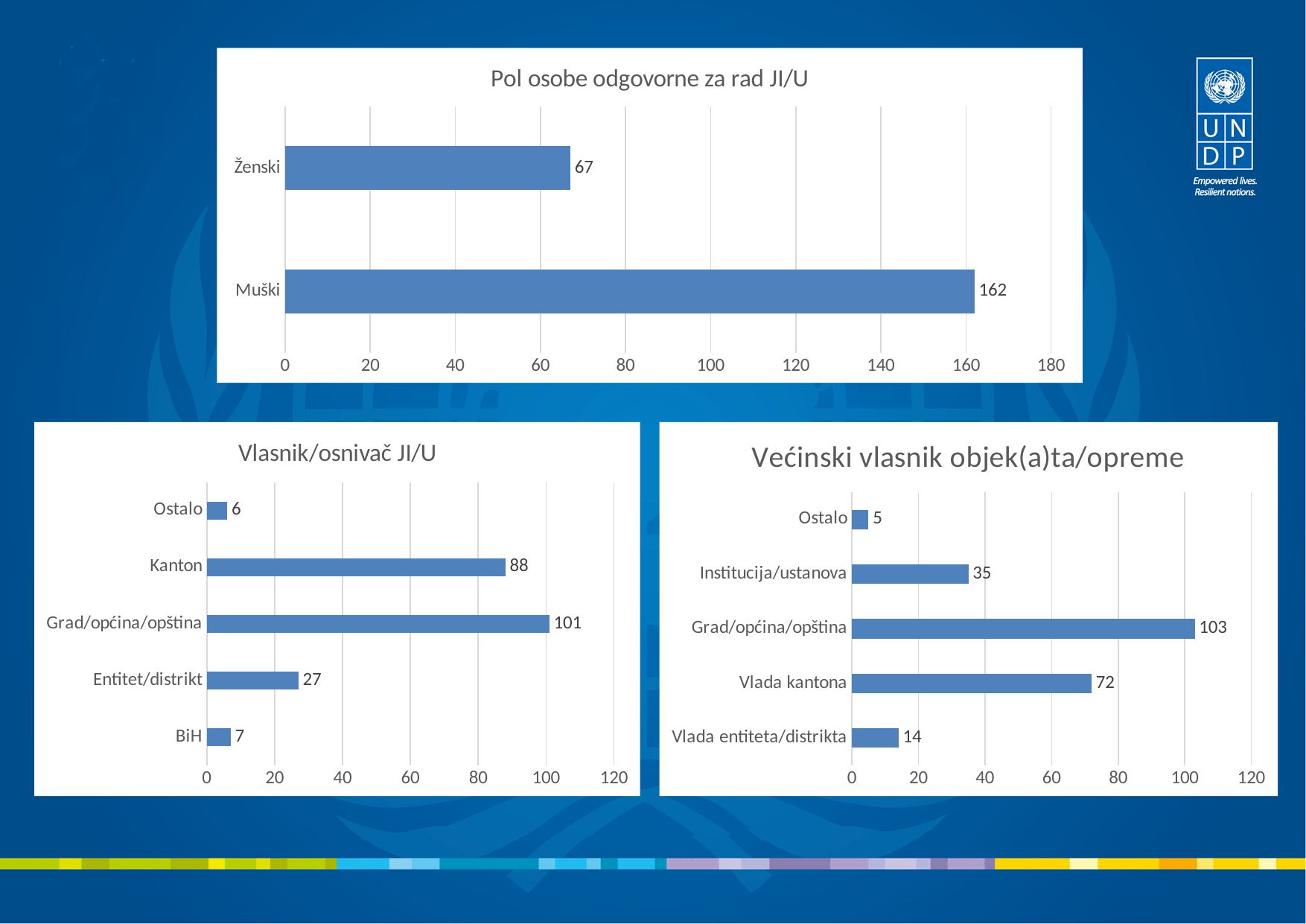
In the chart titled "Većinski vlasnik objek(a)ta/opreme", what is the value for Vlada kantona? 72 What kind of chart is the chart titled "Većinski vlasnik objek(a)ta/opreme"? Bar chart In the chart titled "Vlasnik/osnivač JI/U", what is the value for Kanton? 88 In the chart titled "Vlasnik/osnivač JI/U", which category has the highest value? Grad/općina/opština In the chart titled "Vlasnik/osnivač JI/U", how many categories are shown? 5 In the chart titled "Pol osobe odgovorne za rad JI/U", what is the difference between the values for Muški and Ženski? 95 In the chart titled "Većinski vlasnik objek(a)ta/opreme", what is the difference between Grad/općina/opština and Vlada kantona? 31 In the chart titled "Pol osobe odgovorne za rad JI/U", is the value for Ženski greater or less than 80? less In the chart titled "Vlasnik/osnivač JI/U", which category has the lowest value? Ostalo In the chart titled "Većinski vlasnik objek(a)ta/opreme", which is larger: Institucija/ustanova or Vlada entiteta/distrikta? Institucija/ustanova In the chart titled "Pol osobe odgovorne za rad JI/U", what is the value for Muški? 162 In the chart titled "Pol osobe odgovorne za rad JI/U", how many categories are shown? 2